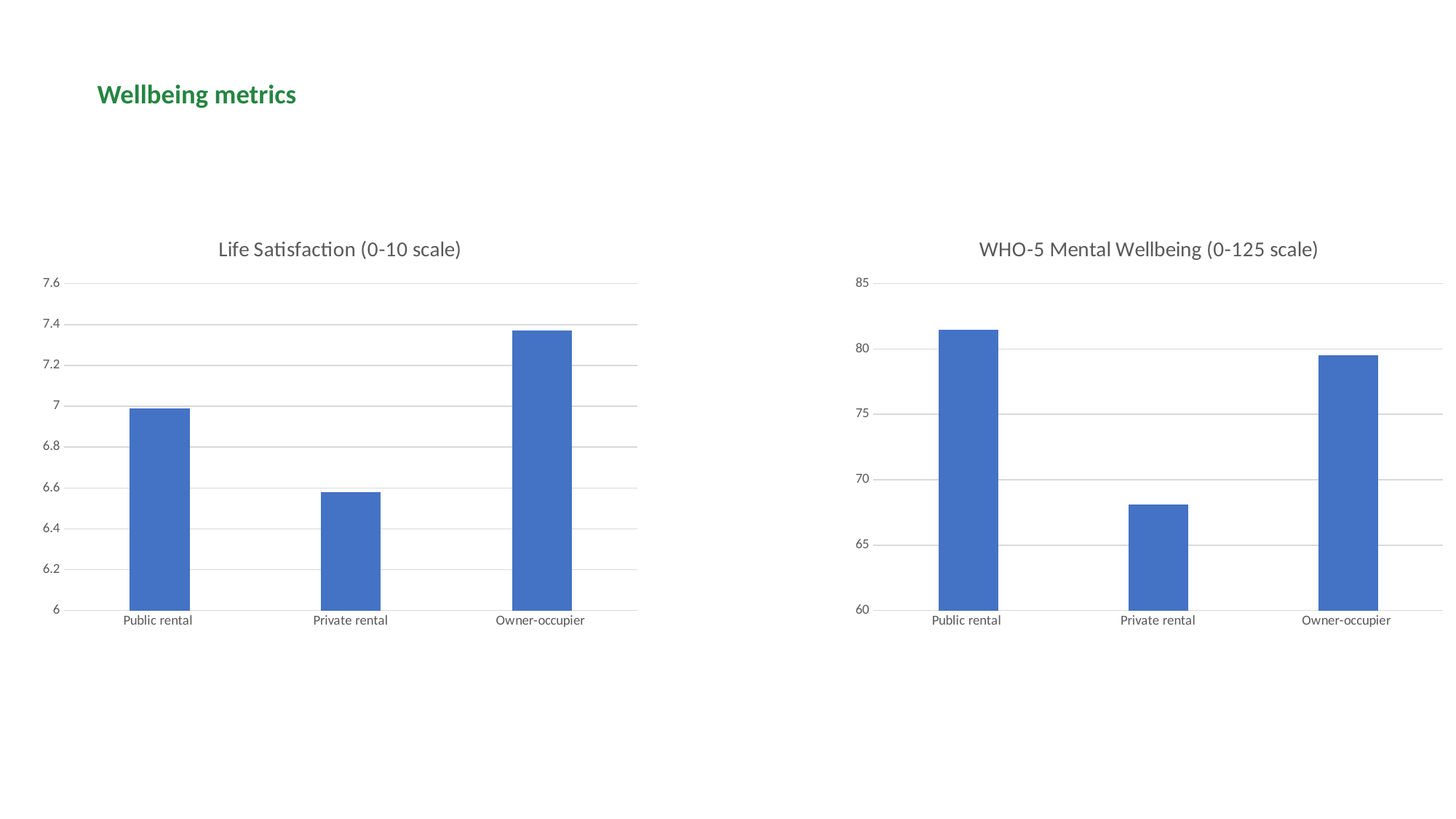
What kind of chart is the Life Satisfaction (0-10 scale) chart? Bar chart In the Life Satisfaction (0-10 scale) chart, is the value for Owner-occupier greater or less than 7.2? greater How many categories are shown in the WHO-5 Mental Wellbeing (0-125 scale) chart? 3 In the Life Satisfaction (0-10 scale) chart, which category has the highest value? Owner-occupier In the WHO-5 Mental Wellbeing (0-125 scale) chart, which category has the lowest value? Private rental In the Life Satisfaction (0-10 scale) chart, is the value for Private rental greater or less than 6.4? greater In the WHO-5 Mental Wellbeing (0-125 scale) chart, which is larger, the value for Private rental or the value for Owner-occupier? Owner-occupier In the Life Satisfaction (0-10 scale) chart, which category has the lowest value? Private rental In the WHO-5 Mental Wellbeing (0-125 scale) chart, is the value for Public rental greater or less than 80? greater In the WHO-5 Mental Wellbeing (0-125 scale) chart, which category has the highest value? Public rental In the Life Satisfaction (0-10 scale) chart, which is larger, the value for Public rental or the value for Private rental? Public rental